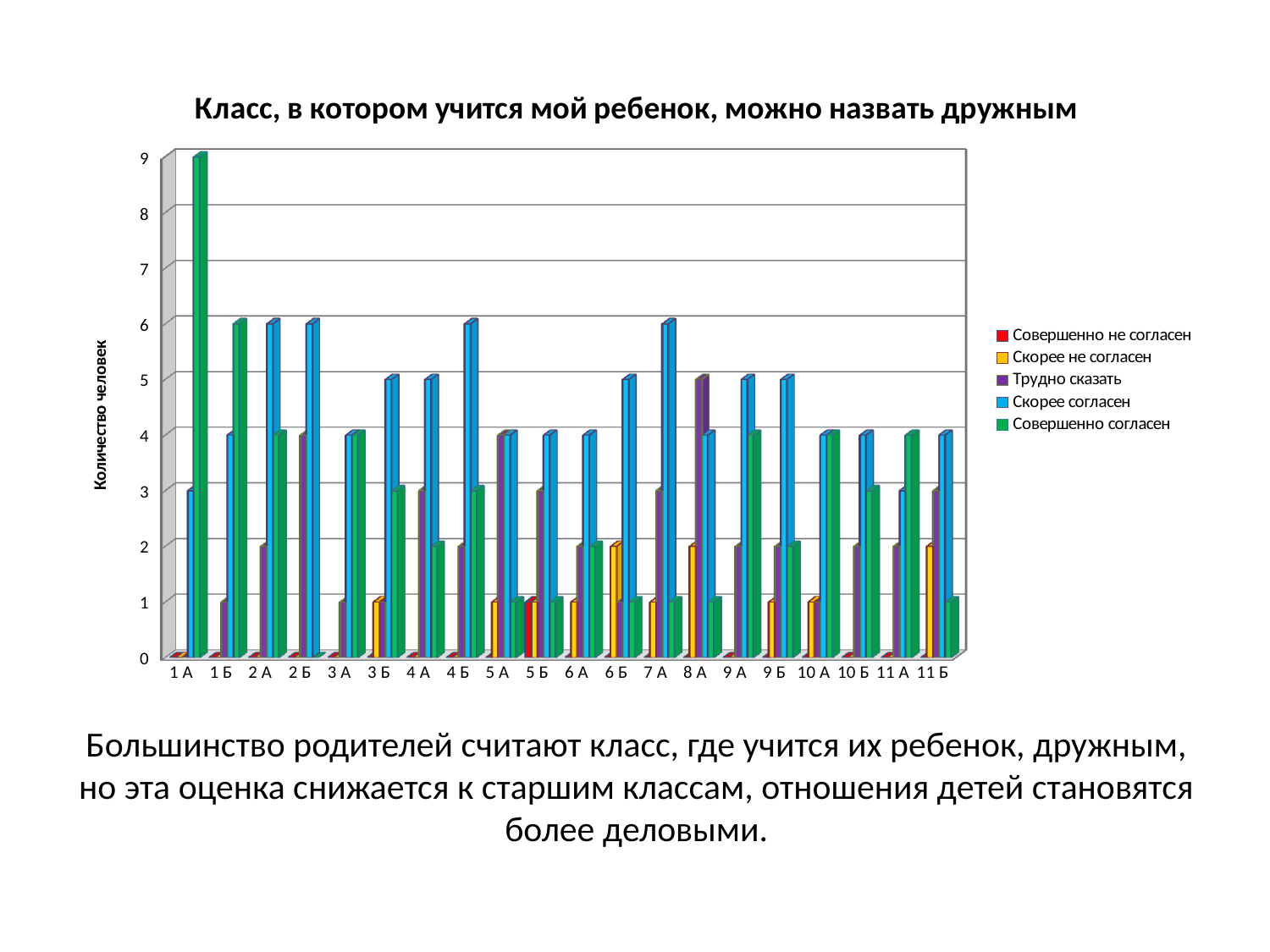
What is the label of the vertical axis? Количество человек Is the value for "Совершенно согласен" in class 11 Б greater or less than 2? less Which class has the highest value for "Совершенно согласен"? 1 А What kind of chart is shown on the slide? bar chart How many classes (categories) are shown on the x axis? 20 Which class has the larger value for "Совершенно согласен": 1 А or 1 Б? 1 А Is the value for "Скорее согласен" in class 7 А greater or less than 5? greater Is the value for "Совершенно согласен" in class 1 А greater or less than 8? greater In class 8 А, which is larger: "Трудно сказать" or "Совершенно согласен"? Трудно сказать What is the title of the chart? Класс, в котором учится мой ребенок, можно назвать дружным How many series does the legend list? 5